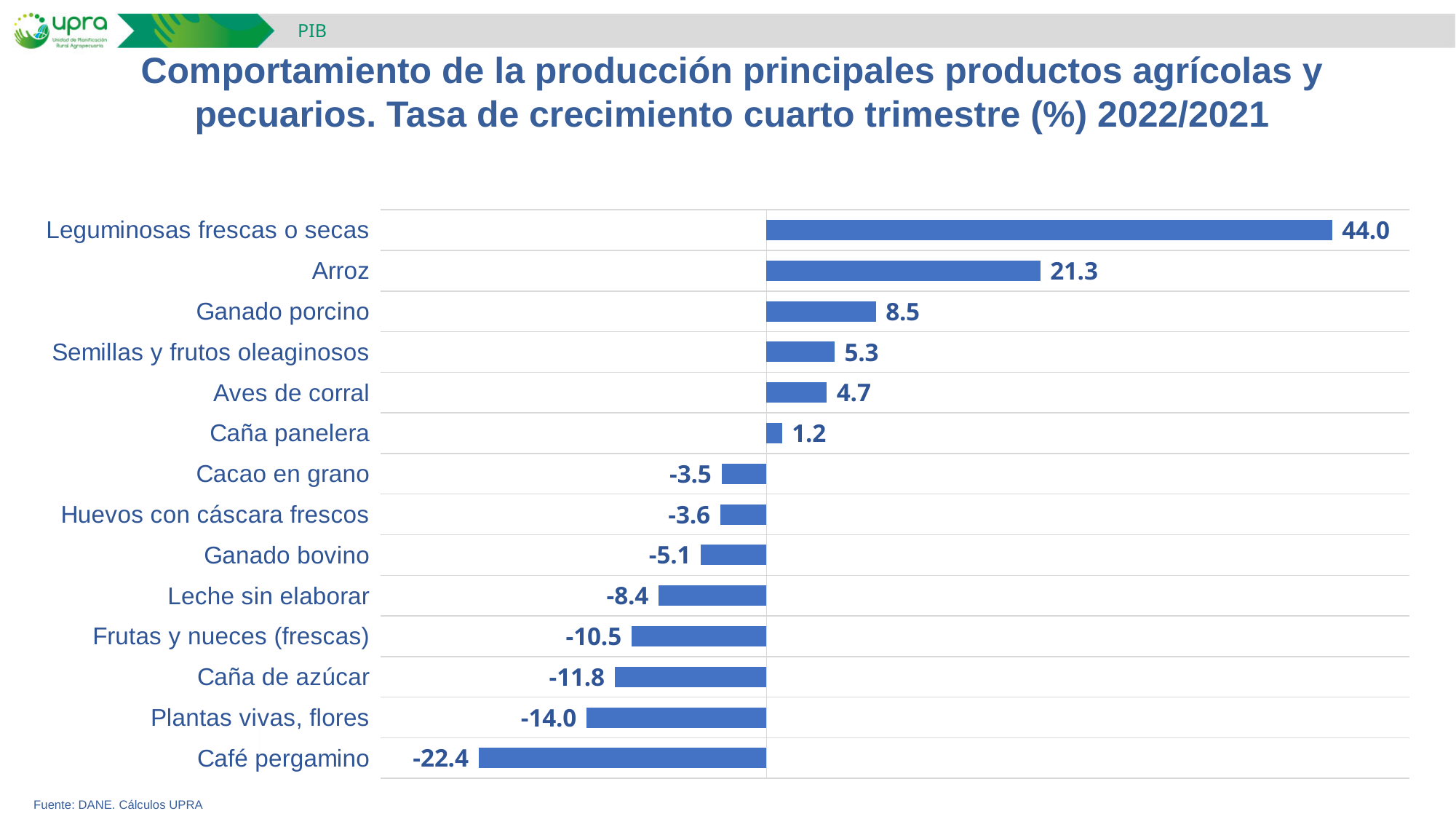
What is the difference between the values for Leguminosas frescas o secas and Arroz? 22.7 How many categories are shown in the chart? 14 Which category has the highest value? Leguminosas frescas o secas Which has a larger value, Caña de azúcar or Plantas vivas, flores? Caña de azúcar Which category has the lowest value? Café pergamino What source is cited for the chart data? DANE. Cálculos UPRA What is the value shown for Aves de corral? 4.7 What is the growth rate shown for Arroz? 21.3 Which has a larger value, Leche sin elaborar or Ganado bovino? Ganado bovino What is the difference between the values for Ganado porcino and Semillas y frutos oleaginosos? 3.2 What kind of chart is shown on the slide? Bar chart What is the value shown for Café pergamino? -22.4